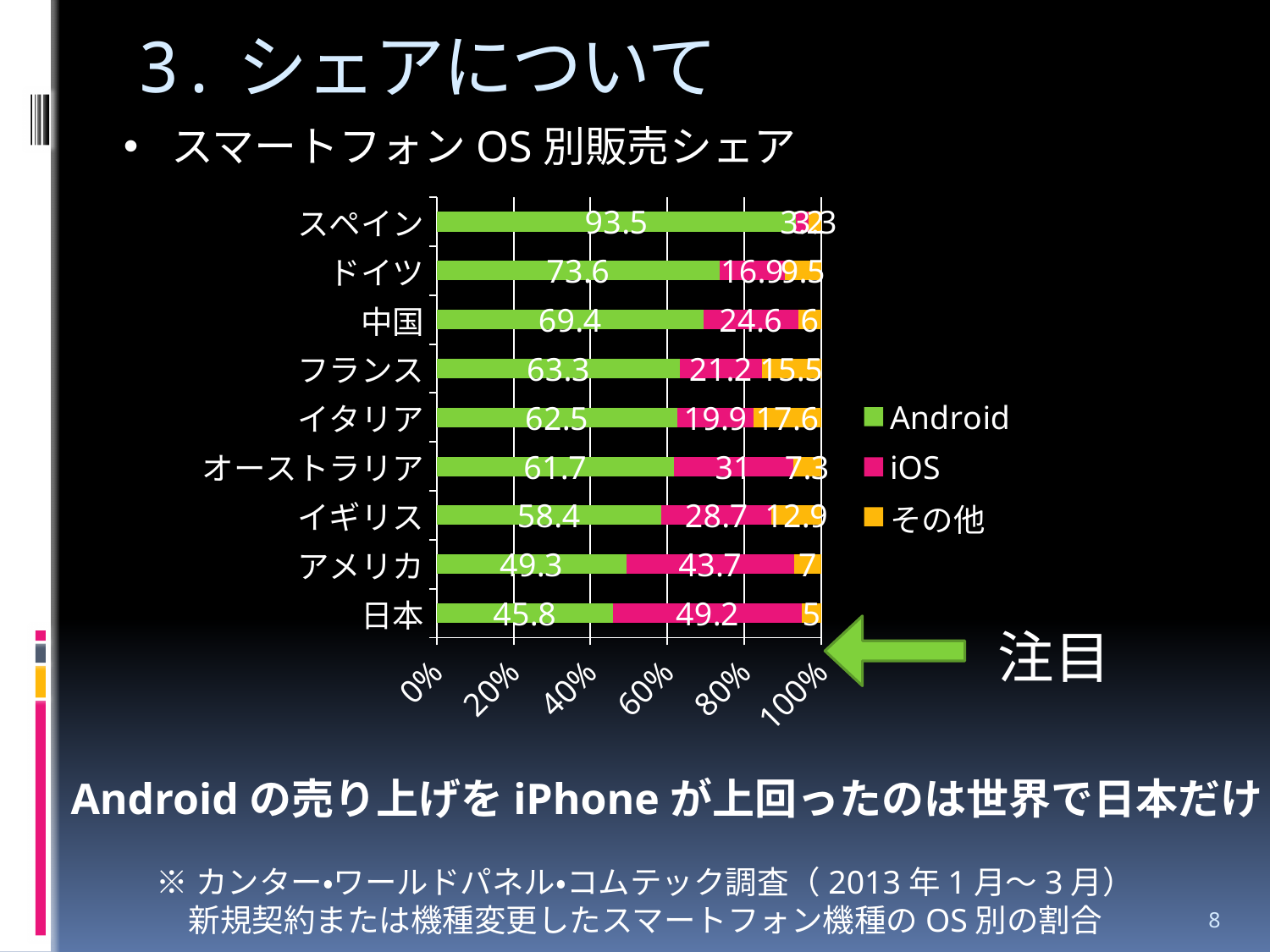
How many countries are shown on the chart? 9 Which country has the lowest Android value? 日本 What is the その他 value for イタリア? 17.6 What is the difference between the Android value for アメリカ and the iOS value for アメリカ? 5.6 Which is larger for 日本: the Android value or the iOS value? iOS What is the iOS value for 日本? 49.2 What kind of chart is shown on the slide? Stacked bar chart How many series does the legend list? 3 Which country has the highest Android value? スペイン What is the Android value for ドイツ? 73.6 Which country has the highest iOS value? 日本 What is the iOS value for オーストラリア? 31